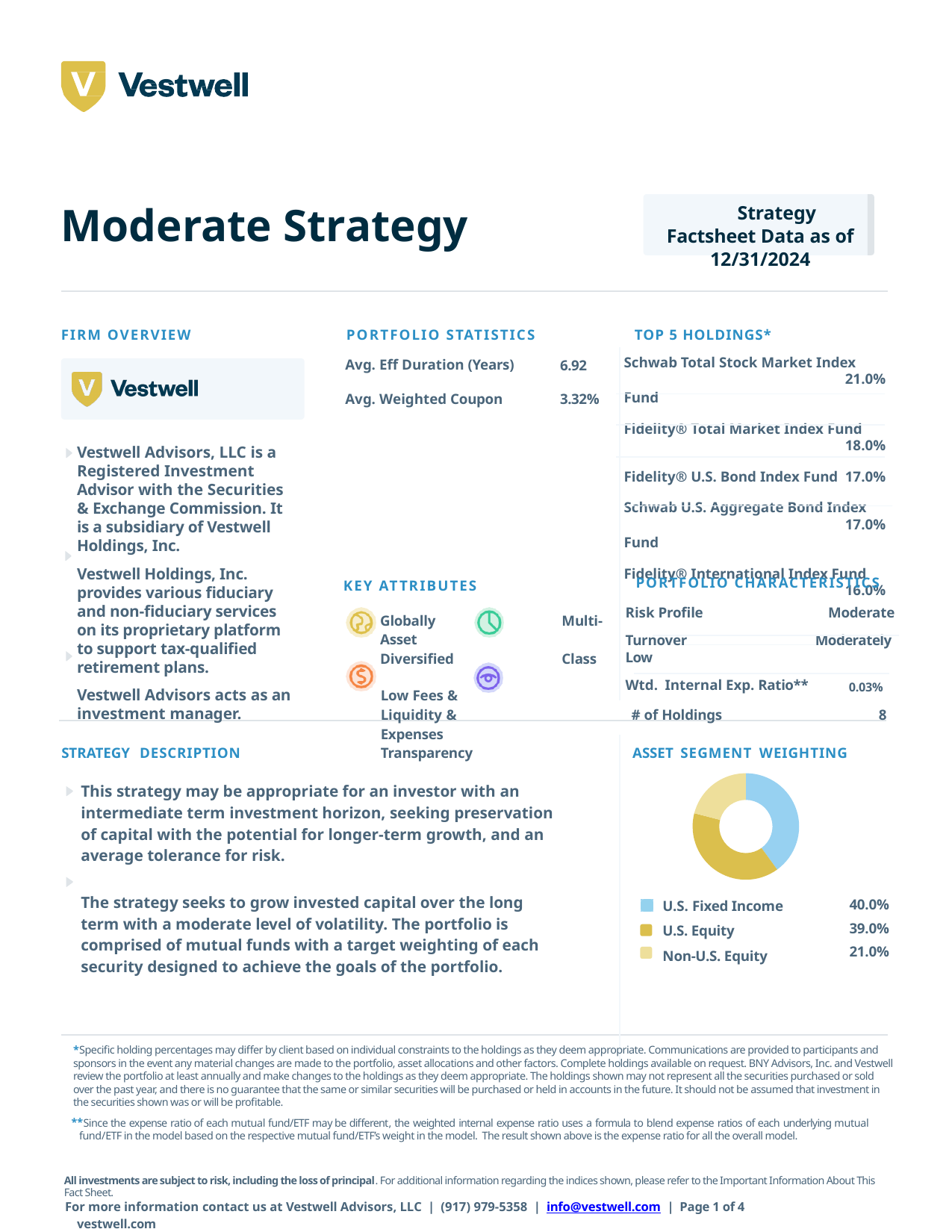
In the Asset Segment Weighting chart, what is the weighting for Non-U.S. Equity? 21.0% In the Asset Segment Weighting chart, what is the weighting for U.S. Fixed Income? 40.0% In the Asset Segment Weighting chart, which segment has the smallest weighting? Non-U.S. Equity In the Asset Segment Weighting chart, what is the weighting for U.S. Equity? 39.0% In the Asset Segment Weighting chart, what is the combined weighting of U.S. Equity and Non-U.S. Equity? 60.0% In the Asset Segment Weighting chart, what is the difference between the U.S. Fixed Income and Non-U.S. Equity weightings? 19.0% In the Asset Segment Weighting chart, what is the difference between the U.S. Equity and Non-U.S. Equity weightings? 18.0% In the Asset Segment Weighting chart, which segment has the largest weighting? U.S. Fixed Income In the Asset Segment Weighting chart, which is larger: U.S. Equity or Non-U.S. Equity? U.S. Equity What is the title of the chart on the slide? Asset Segment Weighting What kind of chart is shown under Asset Segment Weighting? Pie chart (donut) In the Asset Segment Weighting chart, how many segments are shown? 3